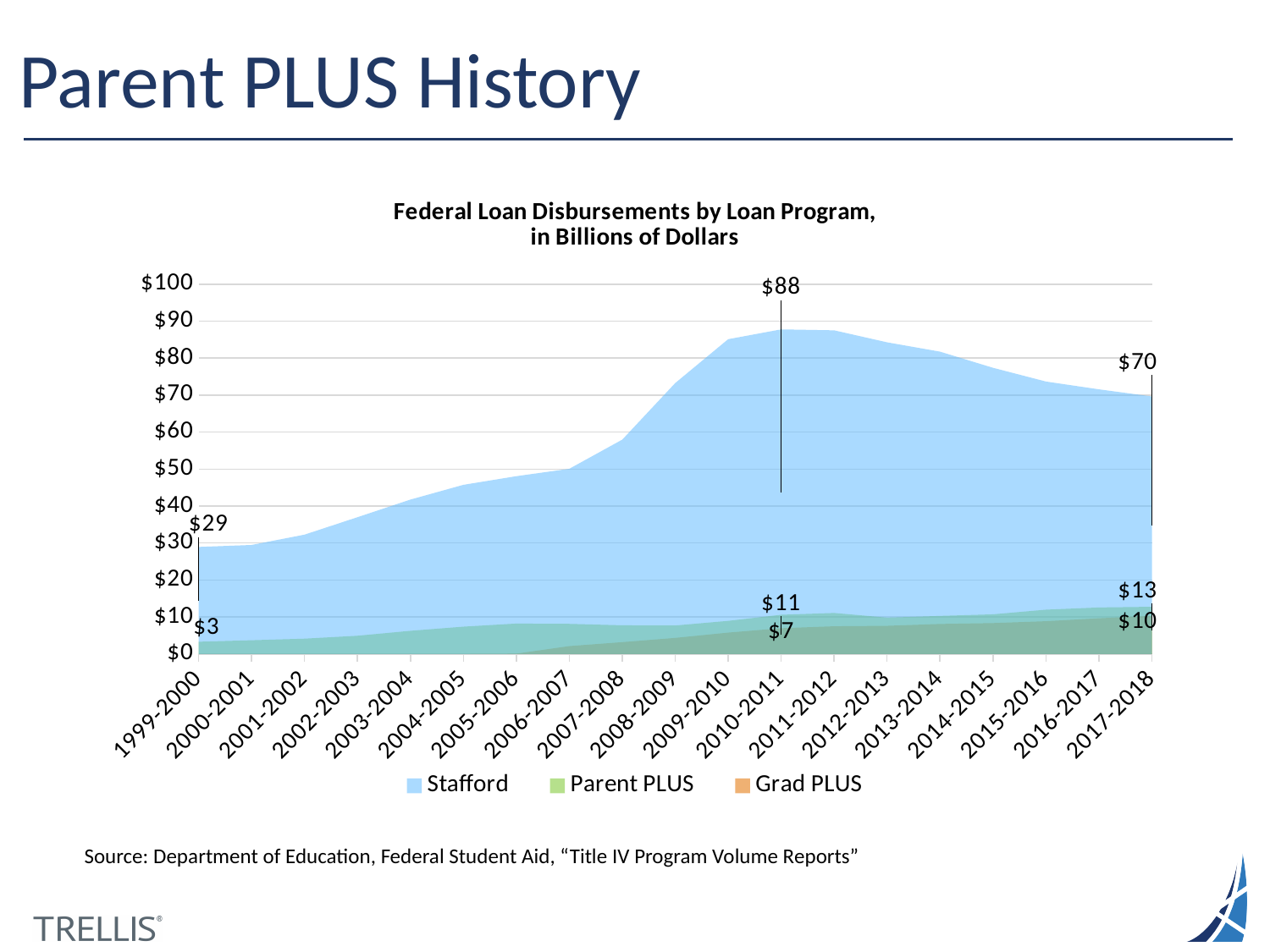
How many series does the chart legend list? 3 What is the Stafford value for 1999-2000? $29 Is the Stafford value for 2004-2005 greater or less than $40? greater What is the title of the chart? Federal Loan Disbursements by Loan Program, in Billions of Dollars Which is larger in 2017-2018, Parent PLUS or Grad PLUS? Parent PLUS What is the Grad PLUS value for 2010-2011? $7 How much higher is the Stafford value in 2010-2011 than in 2017-2018? $18 By how much did the Parent PLUS value grow from 1999-2000 to 2017-2018? $10 What is the Parent PLUS value for 2017-2018? $13 What is the Stafford value for 2010-2011? $88 How many academic years are shown on the x axis? 19 What kind of chart is shown on the slide? area chart